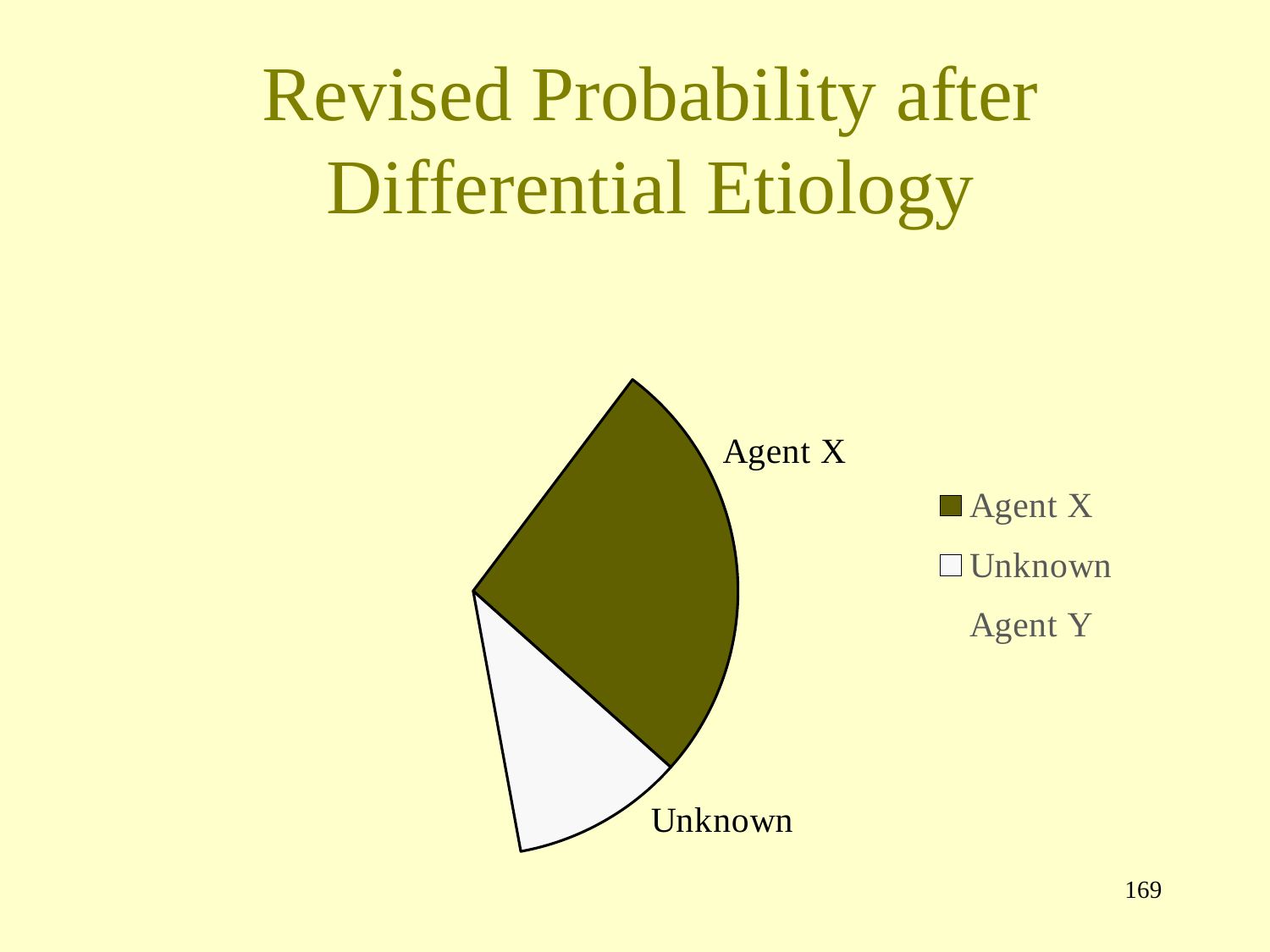
How many labelled slices are visible in the pie? 2 Which legend entry is shown with a dark olive-green swatch? Agent X Which labelled slice of the pie is the smallest? Unknown How many entries does the legend list? 3 Which is larger, the Agent X slice or the Unknown slice? Agent X What is the title of the slide containing the pie chart? Revised Probability after Differential Etiology What kind of chart is shown on the slide? pie chart